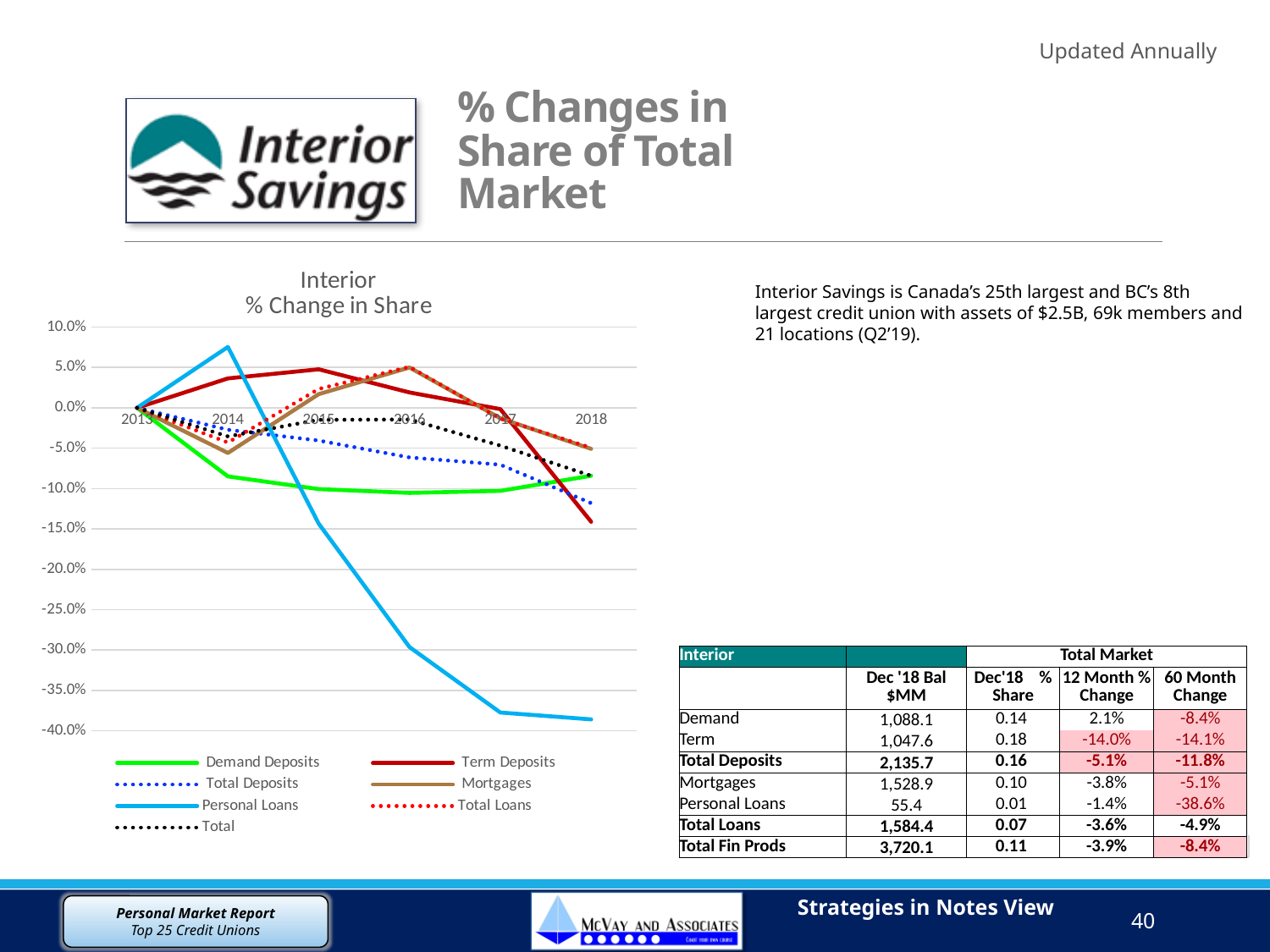
Is the value for Term Deposits in 2018 greater or less than -10.0%? less Which series has the highest value in 2014? Personal Loans Does the Personal Loans line rise or fall from 2014 to 2018? fall Is the value for Personal Loans in 2018 greater or less than -35.0%? less How many years are plotted along the x axis of the chart? 6 In 2015, which is larger: the value for Term Deposits or the value for Demand Deposits? Term Deposits Is the value for Demand Deposits in 2014 greater or less than -10.0%? greater In 2018, which is larger: the value for Demand Deposits or the value for Personal Loans? Demand Deposits What kind of chart is shown on the slide? line chart What is the title of the chart? Interior % Change in Share How many series does the chart legend list? 7 Which series has the lowest value in 2018? Personal Loans